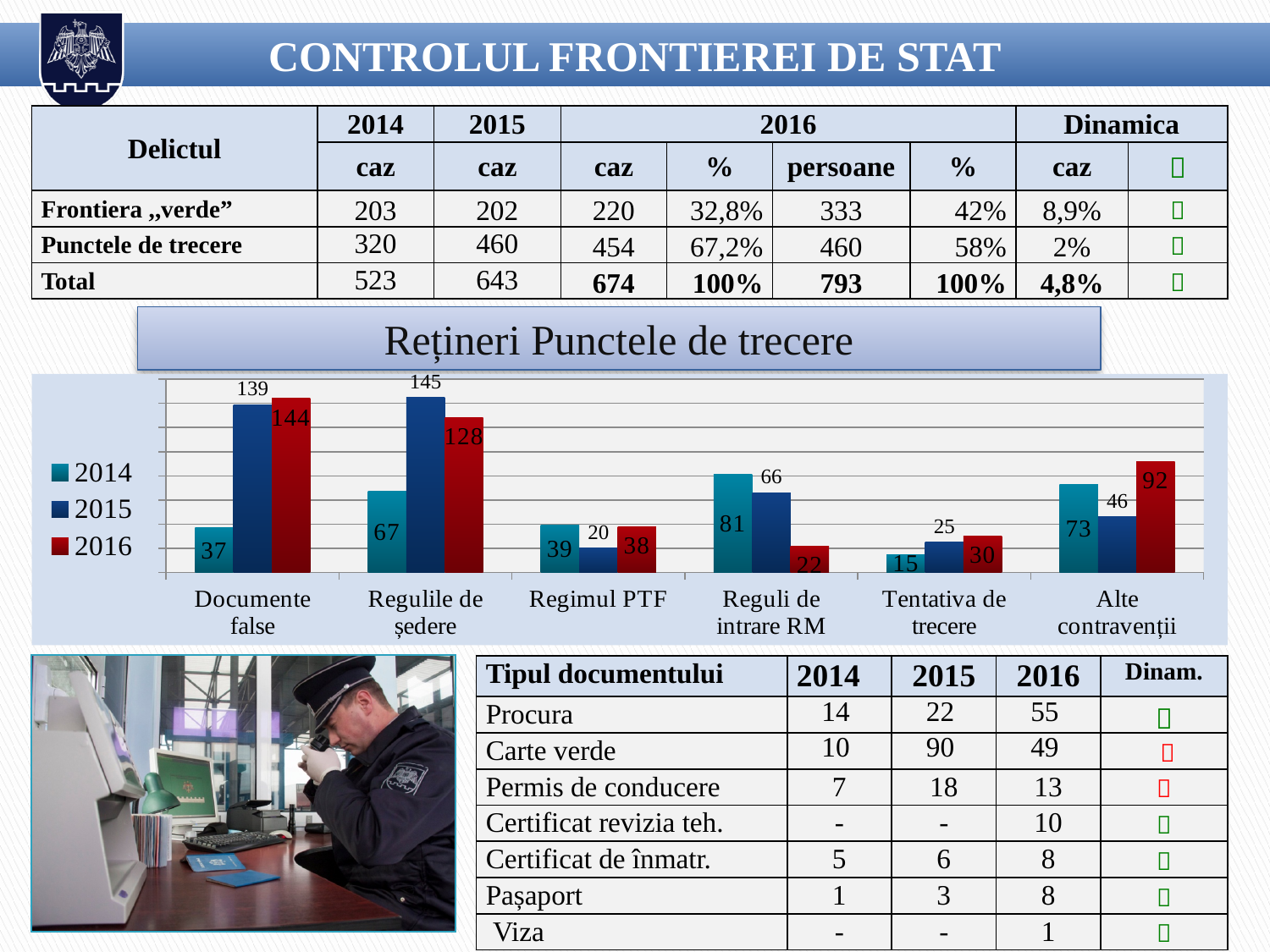
Do the values for the 2016 series rise or fall from Documente false to Regimul PTF? fall What is the value for 2016 in the Documente false category? 144 What is the title of the chart? Rețineri Punctele de trecere How many series does the legend list? 3 Which is larger in the Regimul PTF category: the 2014 value or the 2016 value? 2014 What is the value for 2015 in the Tentativa de trecere category? 25 What kind of chart is shown on the slide? bar chart What is the value for 2014 in the Reguli de intrare RM category? 81 How many categories are shown on the x axis of the chart? 6 What is the difference between the 2016 and 2014 values for Alte contravenții? 19 Which category has the highest value for the 2015 series? Regulile de ședere Which category has the lowest value for the 2014 series? Tentativa de trecere